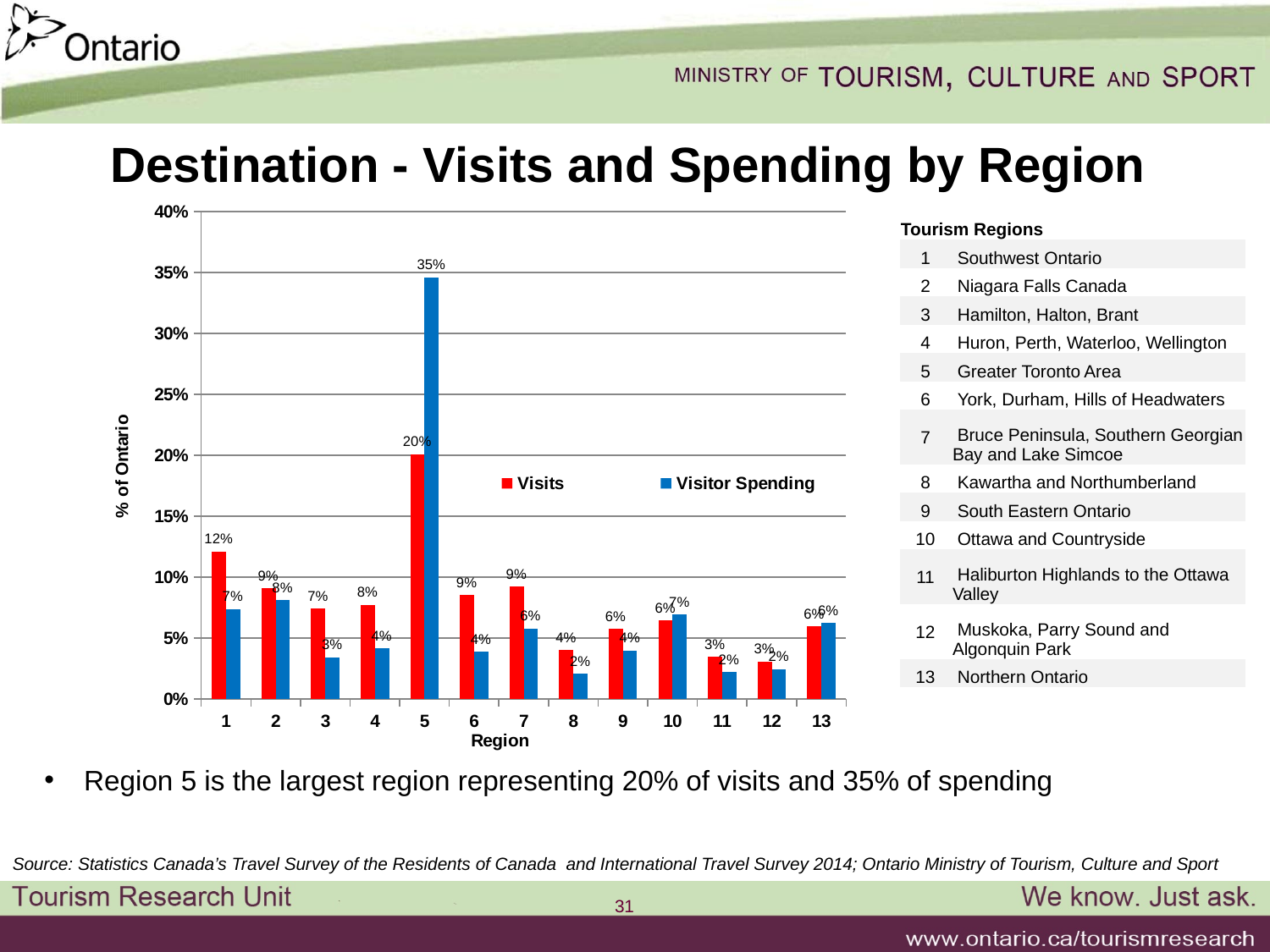
What is the Visitor Spending value for Region 3? 3% Which region has the highest Visits share? Region 5 What is the difference between Visitor Spending and Visits for Region 5? 15% What is the Visitor Spending value for Region 5? 35% What is the Visits value for Region 1? 12% For Region 1, which is larger: Visits or Visitor Spending? Visits How many series does the chart legend list? 2 Which region has the highest Visitor Spending share? Region 5 How many regions are shown on the x axis of the chart? 13 What kind of chart is shown on the slide? Bar chart Is the Visitor Spending value for Region 5 greater or less than 30%? greater What is the Visits value for Region 5? 20%